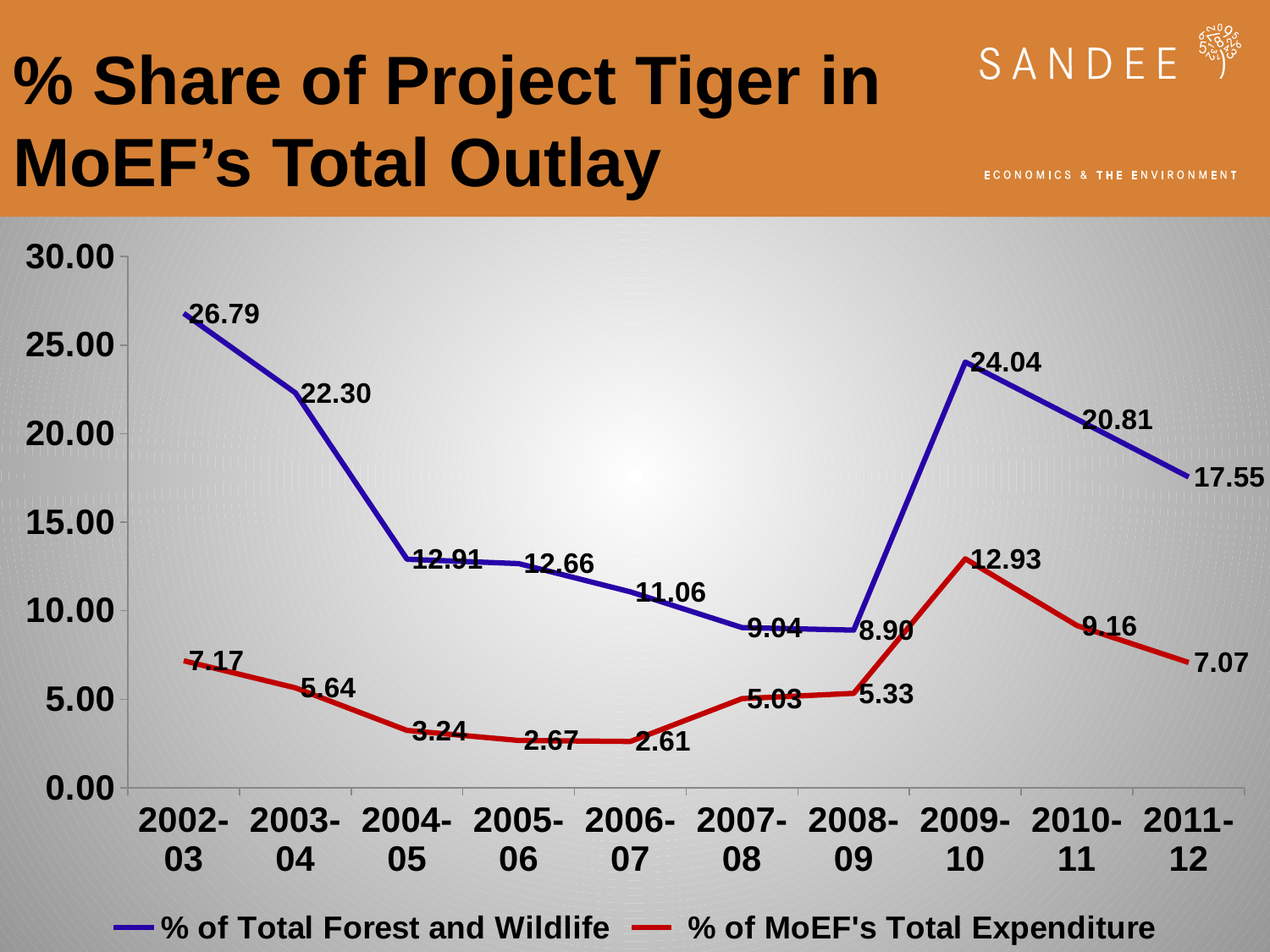
Is the value of % of Total Forest and Wildlife for 2009-10 greater or less than 20.00? greater What kind of chart is shown on the slide? line chart How many years are shown on the x axis? 10 What is the value of % of Total Forest and Wildlife for 2002-03? 26.79 What is the value of % of MoEF's Total Expenditure for 2006-07? 2.61 Which is larger in 2004-05: % of Total Forest and Wildlife or % of MoEF's Total Expenditure? % of Total Forest and Wildlife How many series does the legend list? 2 In which year is % of MoEF's Total Expenditure highest? 2009-10 Does % of Total Forest and Wildlife rise or fall from 2009-10 to 2011-12? fall In which year is % of Total Forest and Wildlife lowest? 2008-09 What is the value of % of MoEF's Total Expenditure for 2009-10? 12.93 What is the difference between % of Total Forest and Wildlife and % of MoEF's Total Expenditure in 2011-12? 10.48